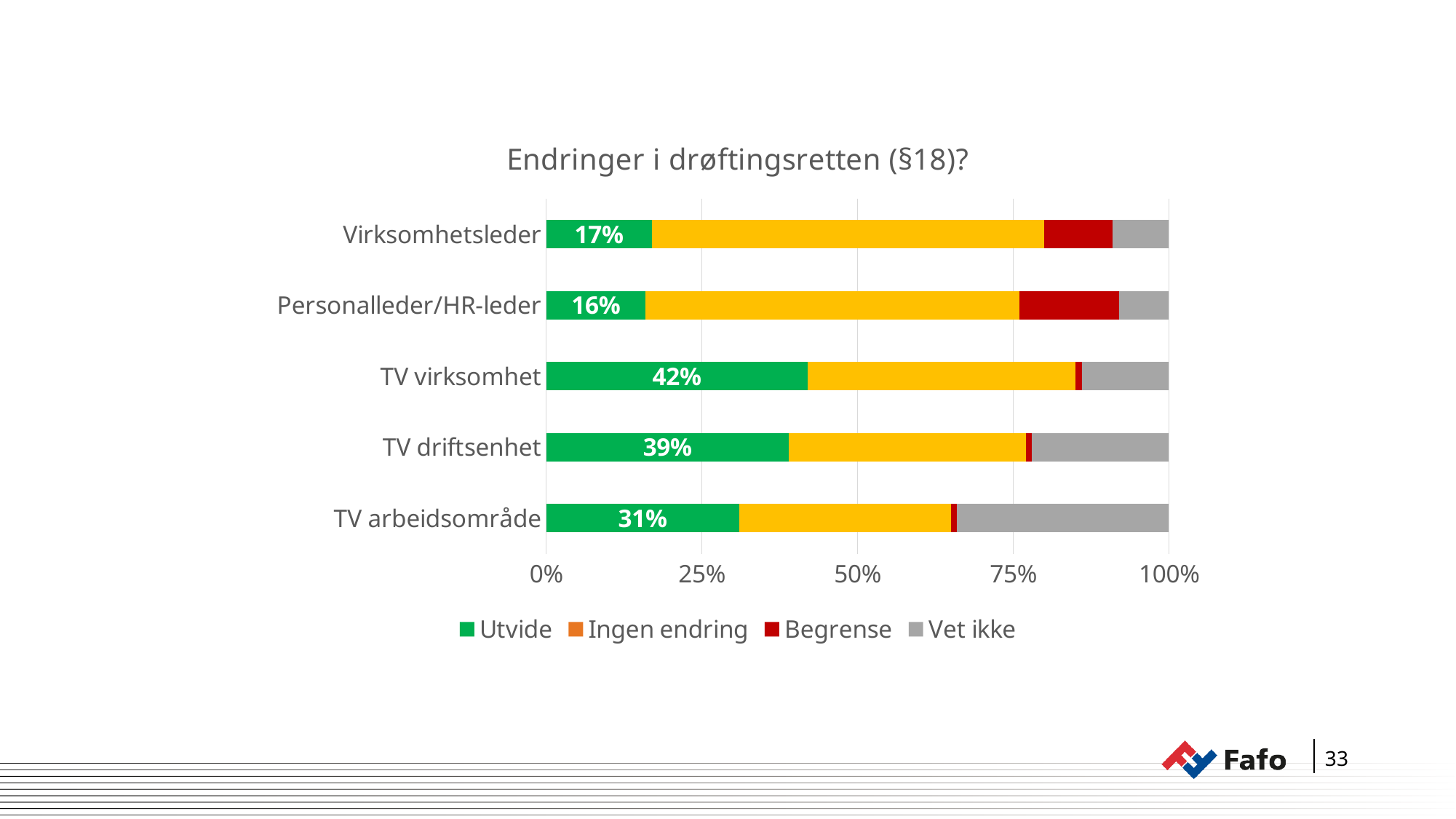
Is the Vet ikke value for TV arbeidsområde greater or less than 25%? greater How many series does the legend list? 4 How many categories are shown on the chart? 5 What kind of chart is shown on the slide? Stacked bar chart What is the Utvide value for Personalleder/HR-leder? 16% What is the Utvide value for Virksomhetsleder? 17% Which has a larger Utvide value, TV driftsenhet or TV arbeidsområde? TV driftsenhet What is the Utvide value for TV virksomhet? 42% What is the difference between the Utvide values for TV virksomhet and Personalleder/HR-leder? 26 percentage points Which category has the highest Utvide value? TV virksomhet Which category has the lowest Utvide value? Personalleder/HR-leder What is the Utvide value for TV arbeidsområde? 31%